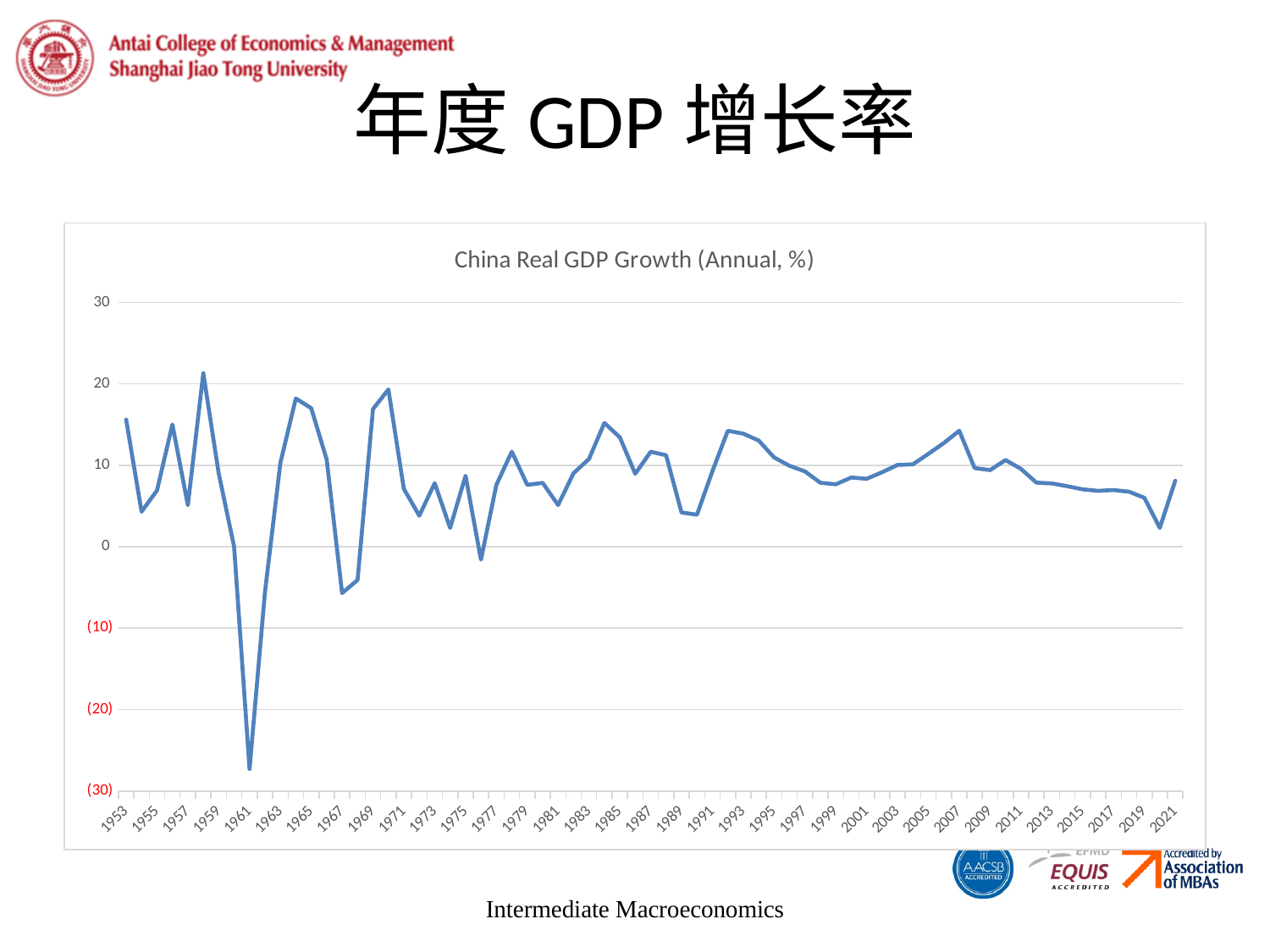
Is the value for 2020 greater or less than 10? less What is the title of the chart? China Real GDP Growth (Annual, %) Which year has the larger value, 2007 or 2020? 2007 Is the value for 1961 greater or less than (20)? less Is the value for 1958 greater or less than 20? greater In which year does the line reach its highest value? 1958 In which year does the line reach its lowest value? 1961 What kind of chart is shown on the slide? line chart Do the values generally rise or fall from 2007 to 2019? fall How many lines are plotted on the chart? 1